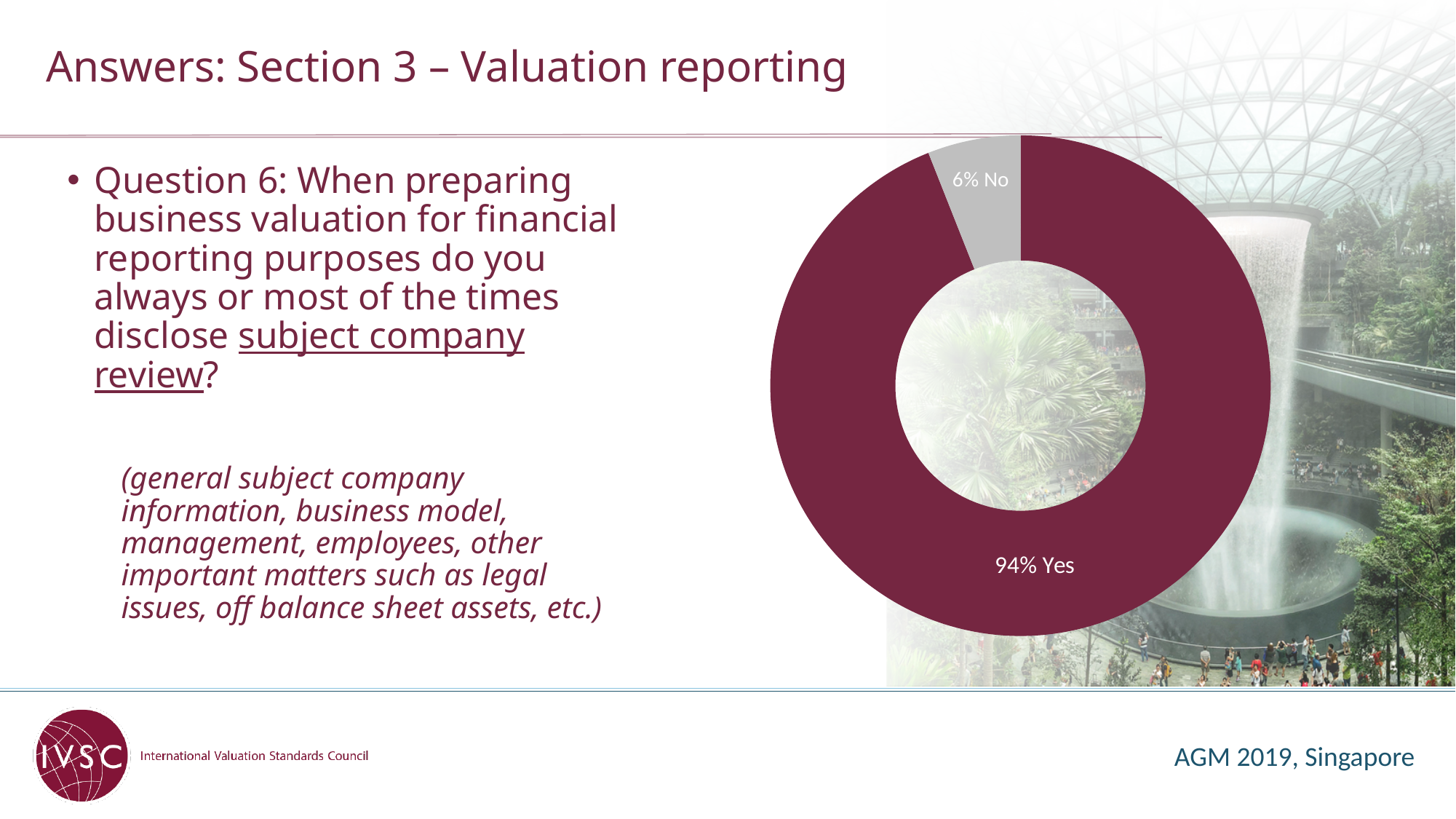
Which response has the smallest share of the chart? No What kind of chart is shown on the slide? Doughnut chart Which is larger, the share for Yes or the share for No? Yes Which response has the largest share of the chart? Yes What share of the chart does the Yes slice represent? 94% How many categories are shown in the chart? 2 What is the difference in percentage points between the Yes and No responses? 88 What colour is the Yes slice of the chart? Dark red What percentage of respondents answered Yes? 94% What percentage of respondents answered No? 6% What colour is the No slice of the chart? Grey